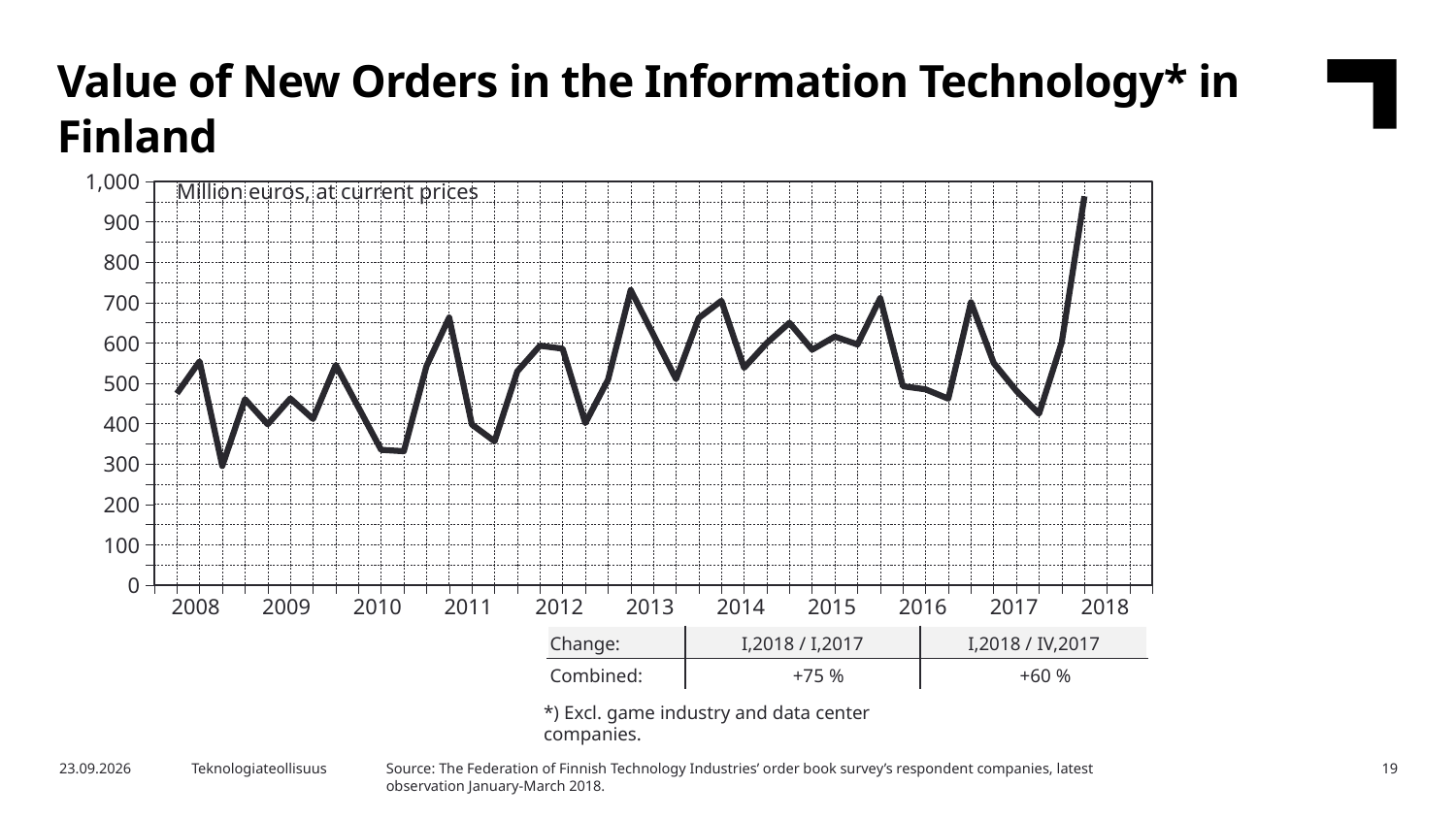
What is the combined change for I,2018 / I,2017 shown in the table below the chart? +75 % How many year labels are shown on the x axis? 11 In which year does the line reach its lowest point? 2008 In what unit are the values on the chart expressed, according to the label inside the plot area? Million euros, at current prices In which year does the line reach its highest point? 2018 Is the peak value in 2013 greater or less than 600? greater What is the title of the chart? Value of New Orders in the Information Technology* in Finland What is the combined change for I,2018 / IV,2017 shown in the table below the chart? +60 % Does the line rise or fall between the end of 2017 and the start of 2018? rise Is the lowest value in 2008 greater or less than 400? less What type of chart is shown on the slide? Line chart Is the value at the start of 2018 greater or less than 900? greater